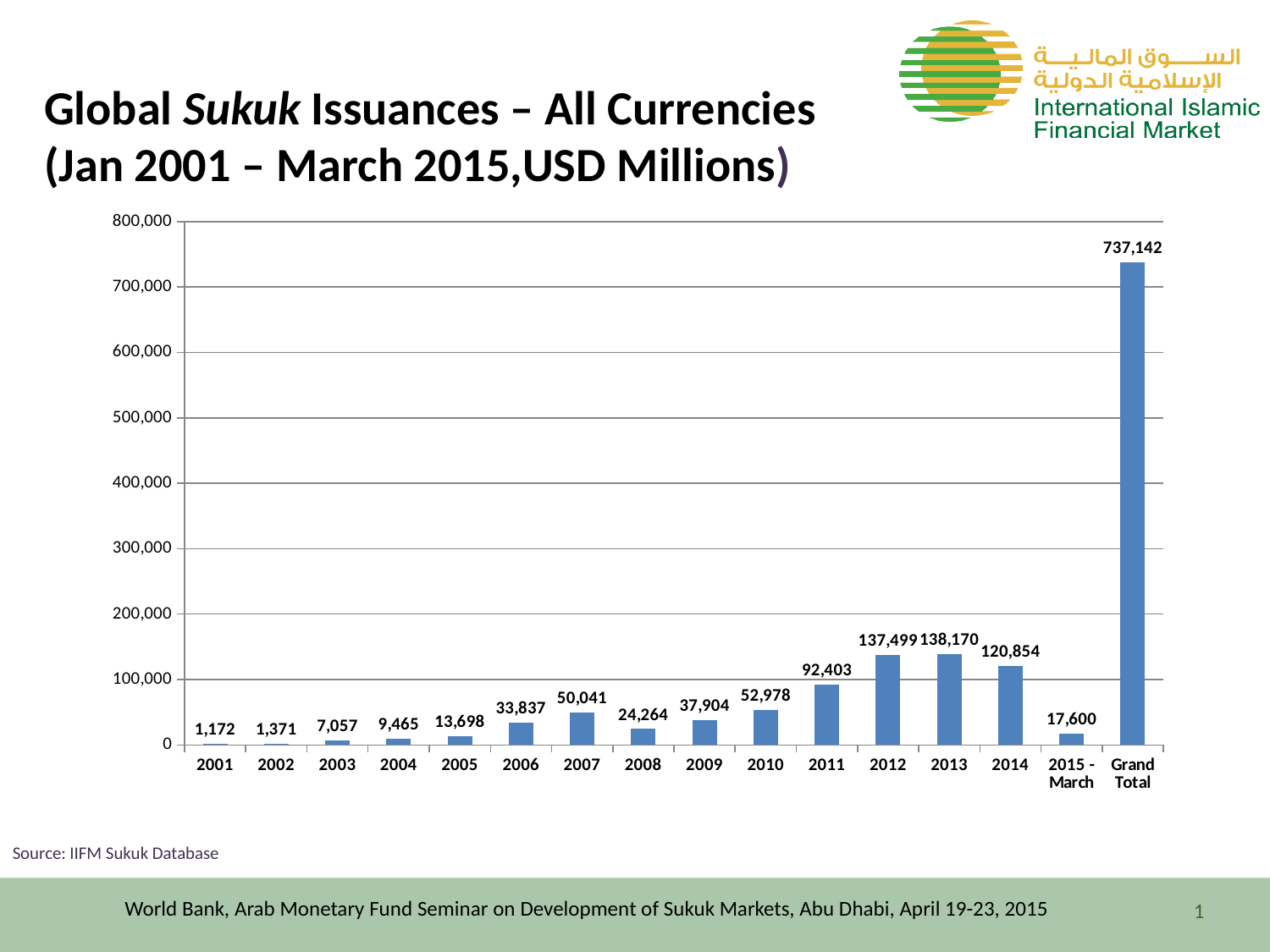
What is the difference between the values for 2014 and 2011? 28,451 Is the value for 2011 greater or less than 100,000? less How many bars are shown on the chart? 16 What is the value for 2015 - March? 17,600 What is the value for 2008? 24,264 What is the value for 2013? 138,170 Which bar is the highest on the chart? Grand Total What is the value shown for the Grand Total bar? 737,142 Do the values rise or fall from 2009 to 2013? rise What is the difference between the values for 2010 and 2009? 15,074 Which is larger, the value for 2007 or the value for 2008? 2007 What kind of chart is shown on the slide? bar chart